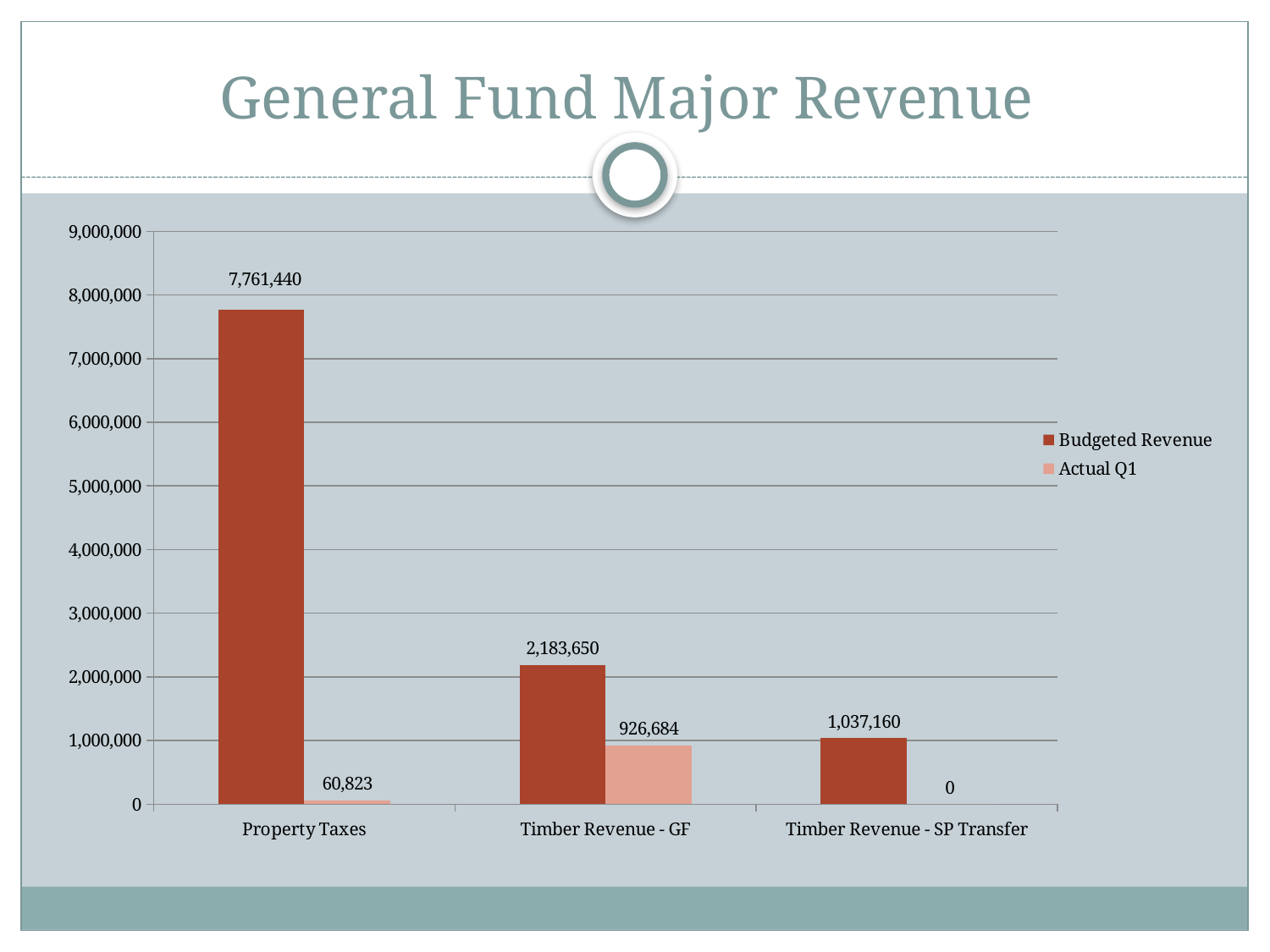
Which category has the highest Budgeted Revenue? Property Taxes What is the title of the slide? General Fund Major Revenue How many series does the legend list? 2 What is the Budgeted Revenue for Property Taxes? 7,761,440 What is the Actual Q1 value for Timber Revenue - SP Transfer? 0 Which category has the lowest Actual Q1 value? Timber Revenue - SP Transfer What is the difference between Budgeted Revenue and Actual Q1 for Timber Revenue - GF? 1,256,966 How many categories are shown on the x axis? 3 Which is larger: the Budgeted Revenue for Timber Revenue - GF or for Timber Revenue - SP Transfer? Timber Revenue - GF What is the Actual Q1 value for Timber Revenue - GF? 926,684 What kind of chart is shown on the slide? bar chart Is the Budgeted Revenue for Timber Revenue - SP Transfer greater or less than 2,000,000? less